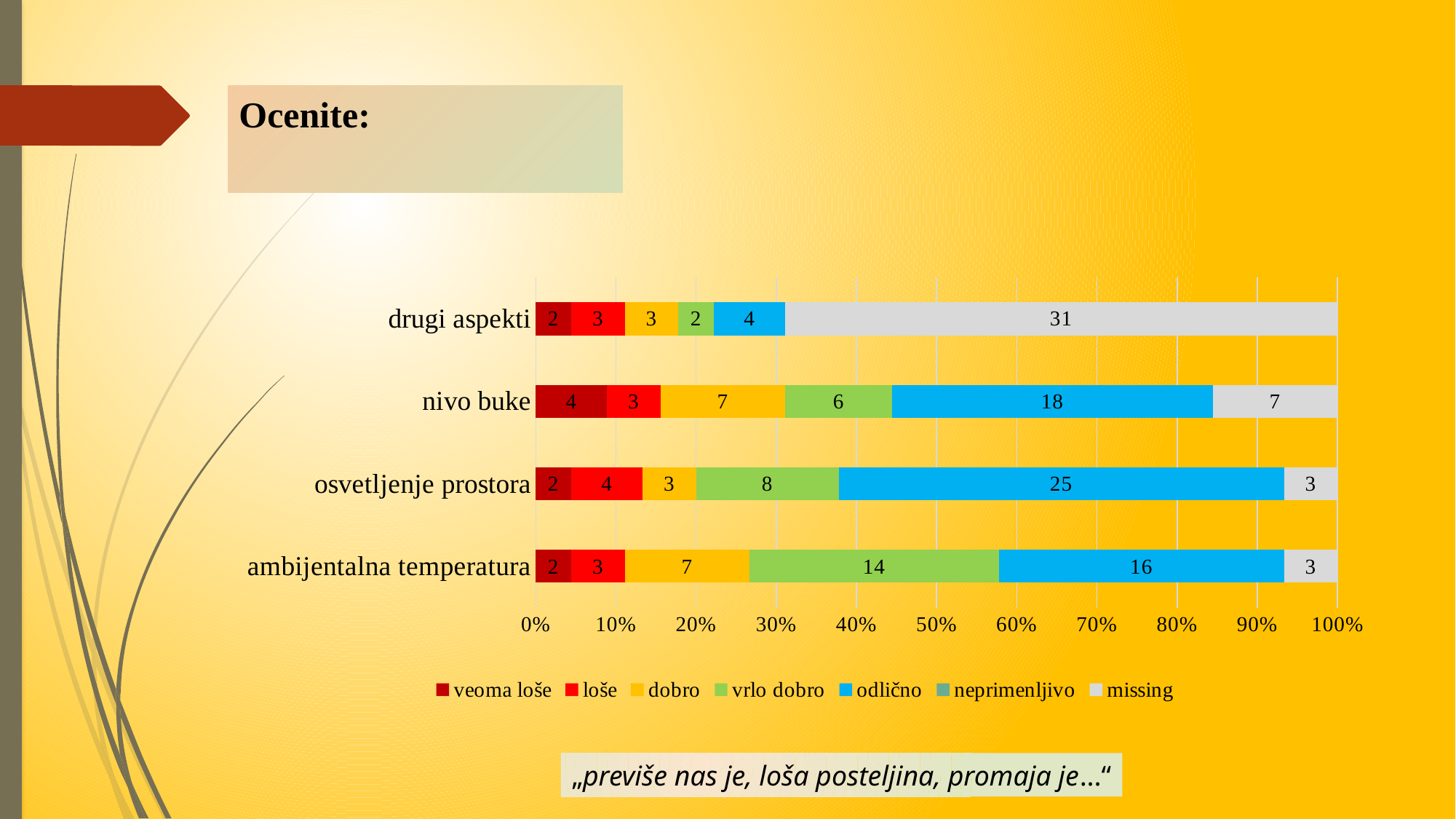
Which category has the highest value for "odlično"? osvetljenje prostora What kind of chart is shown on the slide? stacked bar chart Which category has the lowest value for "odlično"? drugi aspekti What is the value for "missing" in the "drugi aspekti" bar? 31 What is the difference between the "odlično" values for "nivo buke" and "ambijentalna temperatura"? 2 How many series does the legend list? 7 How many categories are shown on the chart? 4 Which has the larger "vrlo dobro" value, "ambijentalna temperatura" or "osvetljenje prostora"? ambijentalna temperatura What is the total of all segments in the "nivo buke" bar? 45 What is the value for "vrlo dobro" in the "ambijentalna temperatura" bar? 14 What is the value for "odlično" in the "osvetljenje prostora" bar? 25 What is the value for "veoma loše" in the "nivo buke" bar? 4